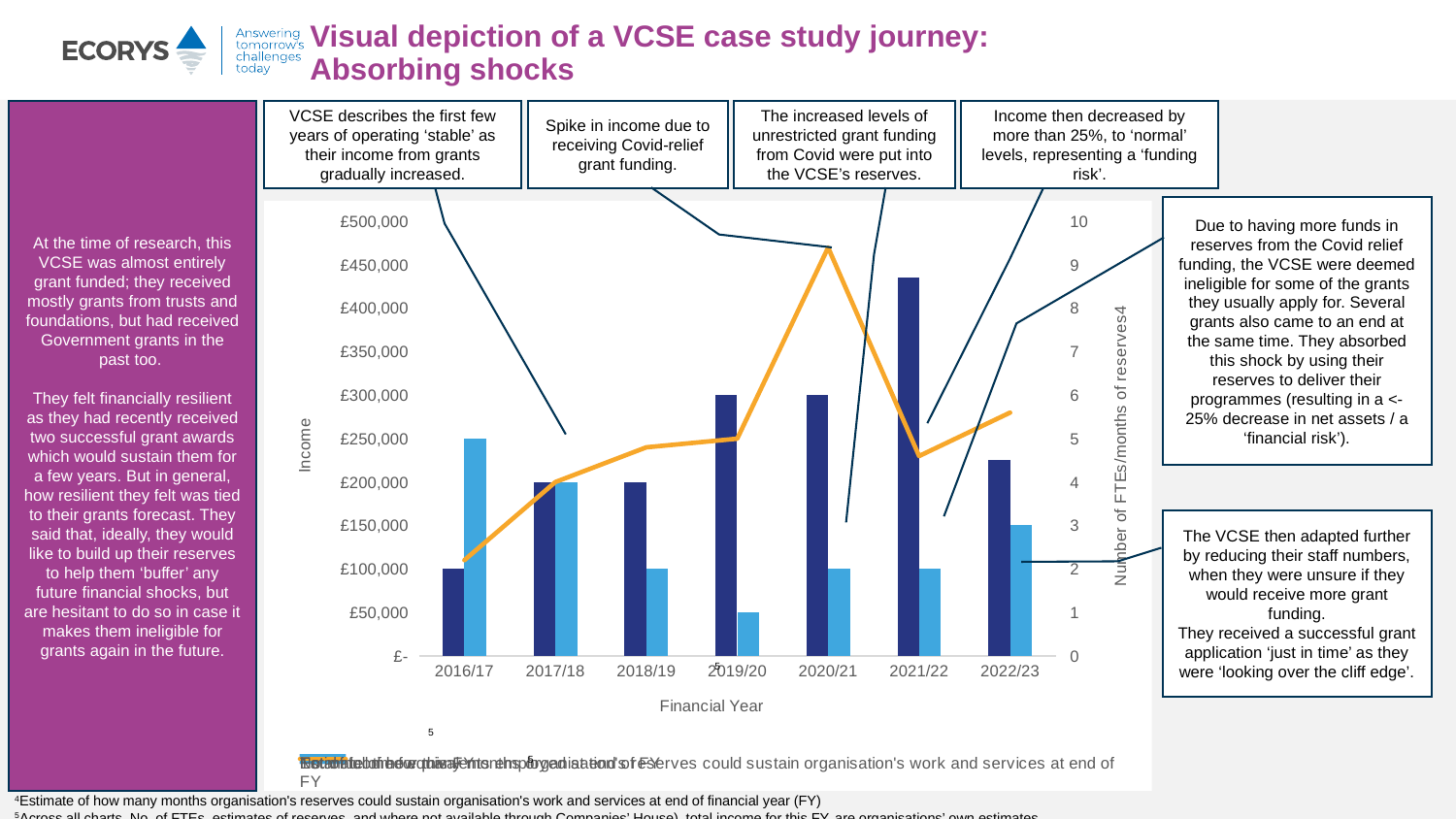
Is the value of the orange line for 2016/17 greater or less than £150,000? less What is the title of the x axis of the chart? Financial Year In which financial year does the orange line reach its highest point? 2020/21 What kind of chart is shown on the slide? A combined bar and line chart In which financial year is the orange line at its lowest point? 2016/17 Is the value of the orange line for 2020/21 greater or less than £400,000? greater In which financial year is the light blue bar the shortest? 2019/20 What is the title of the left-hand vertical axis of the chart? Income In which financial year is the dark blue bar the tallest? 2021/22 How many financial years are shown on the x axis of the chart? 7 Which has the higher orange line value, 2020/21 or 2022/23? 2020/21 Does the orange line rise or fall between 2016/17 and 2020/21? It rises